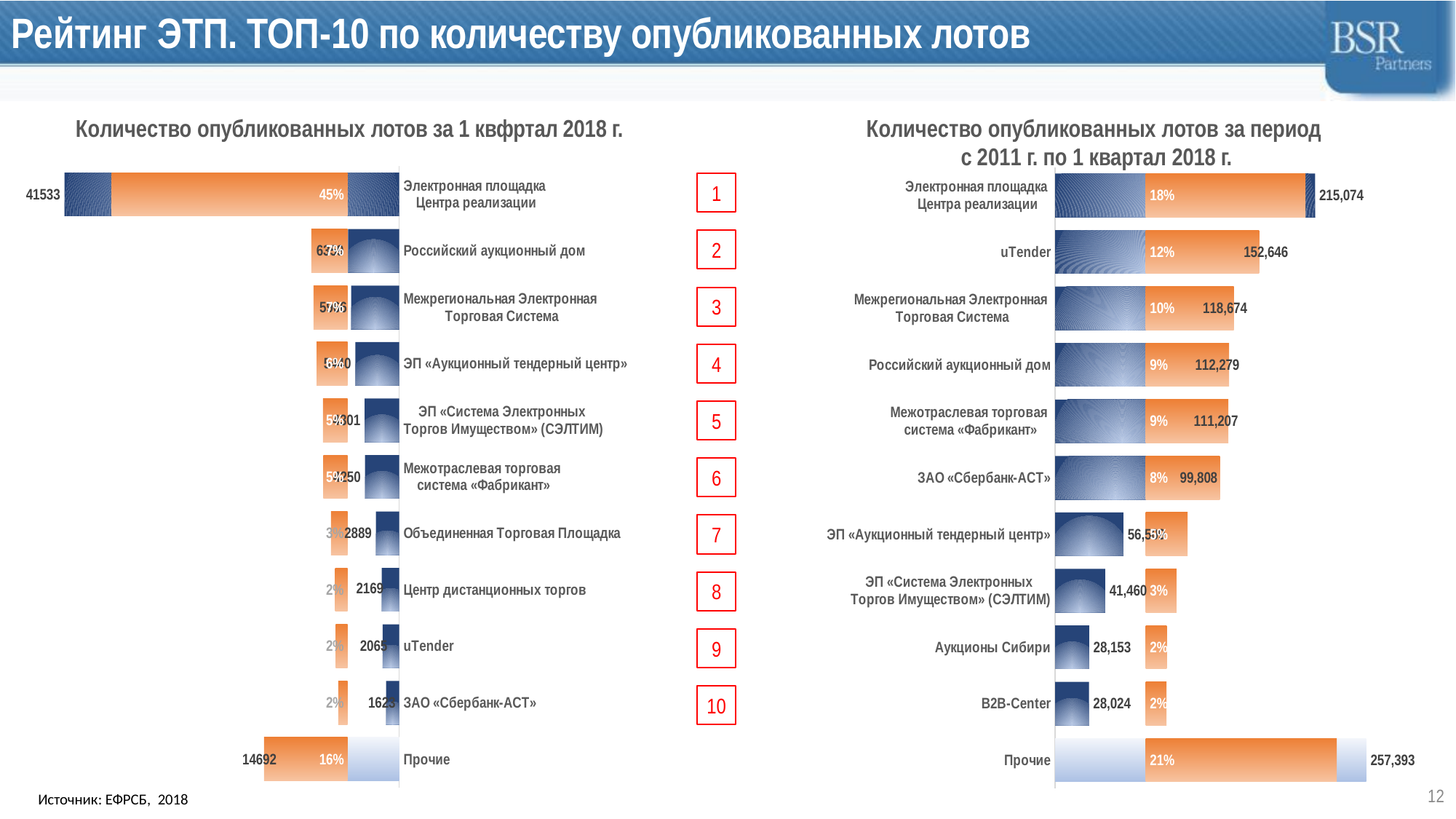
In the right chart (2011 to 1st quarter 2018), how many lots are shown for Прочие? 257,393 In the left chart (1st quarter 2018), how many published lots does Электронная площадка Центра реализации have? 41533 In the left chart (1st quarter 2018), what share of lots does Электронная площадка Центра реализации hold? 45% What type of chart is used on the right side of the slide? Bar chart In the right chart (2011 to 1st quarter 2018), what share of lots does Электронная площадка Центра реализации hold? 18% In the left chart (1st quarter 2018), how many lots are shown for Прочие? 14692 In the left chart (1st quarter 2018), what is the difference in lots between Центр дистанционных торгов and uTender? 104 In the right chart (2011 to 1st quarter 2018), how many lots does uTender have? 152,646 In the right chart (2011 to 1st quarter 2018), which has more lots: Межрегиональная Электронная Торговая Система or Российский аукционный дом? Межрегиональная Электронная Торговая Система In the left chart (1st quarter 2018), how many lots does uTender have? 2065 In the left chart (1st quarter 2018), which platform has the highest number of published lots? Электронная площадка Центра реализации In the right chart (2011 to 1st quarter 2018), what is the difference in lots between Электронная площадка Центра реализации and uTender? 62,428